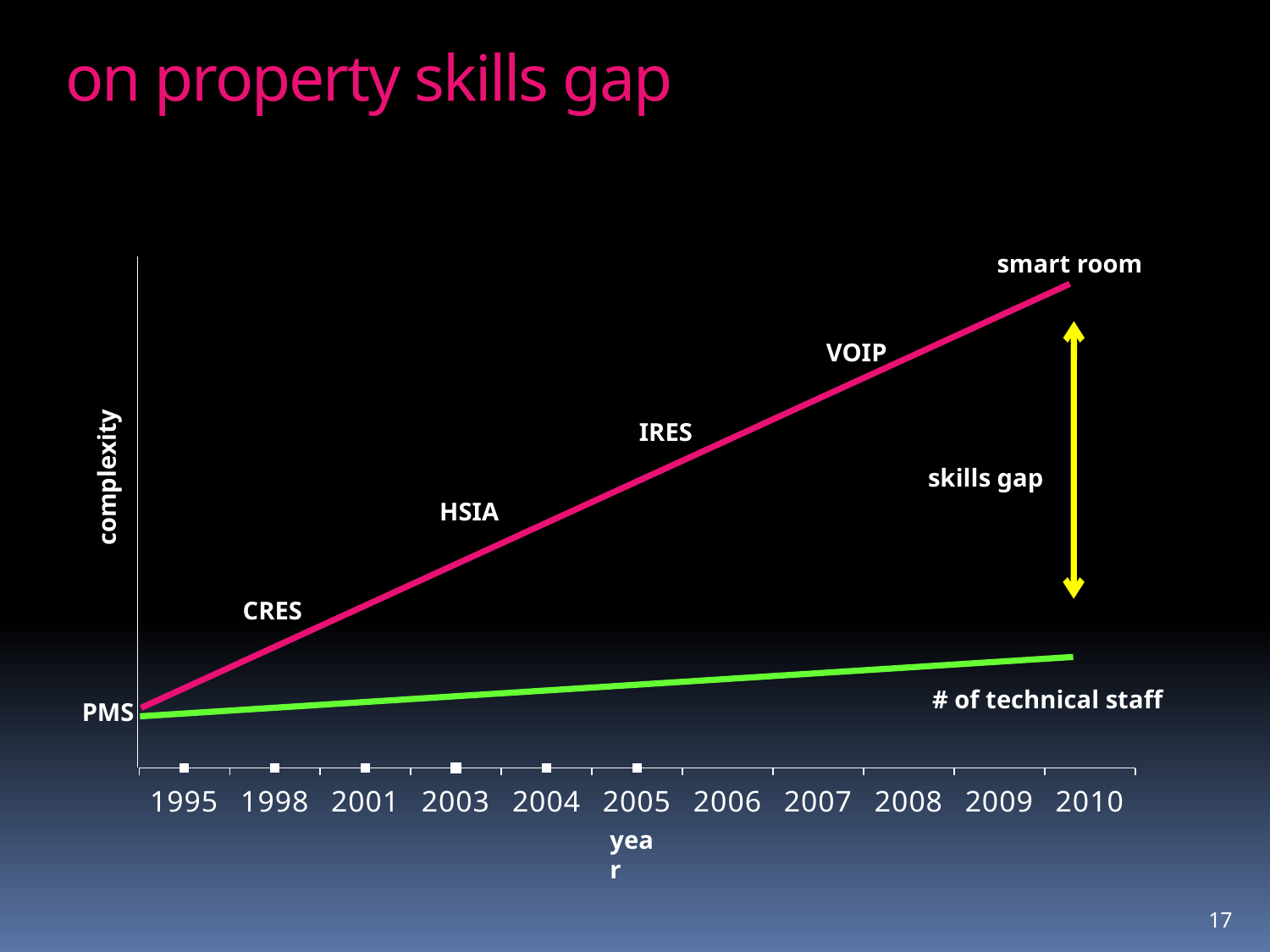
How many lines are plotted on the chart? 2 Which line rises more steeply over the years, the pink line or the green line? the pink line What is the first year label on the x axis? 1995 Does the green '# of technical staff' line rise or fall from 1995 to 2010? rise Does the pink complexity line rise or fall from 1995 to 2010? rise How many year labels are shown along the x axis? 11 What is the label on the y axis? complexity At 2010, which line is higher: the pink complexity line or the green '# of technical staff' line? the pink complexity line What kind of chart is shown on the slide? line chart What does the yellow double-headed arrow on the right of the chart represent? skills gap What is the last year label on the x axis? 2010